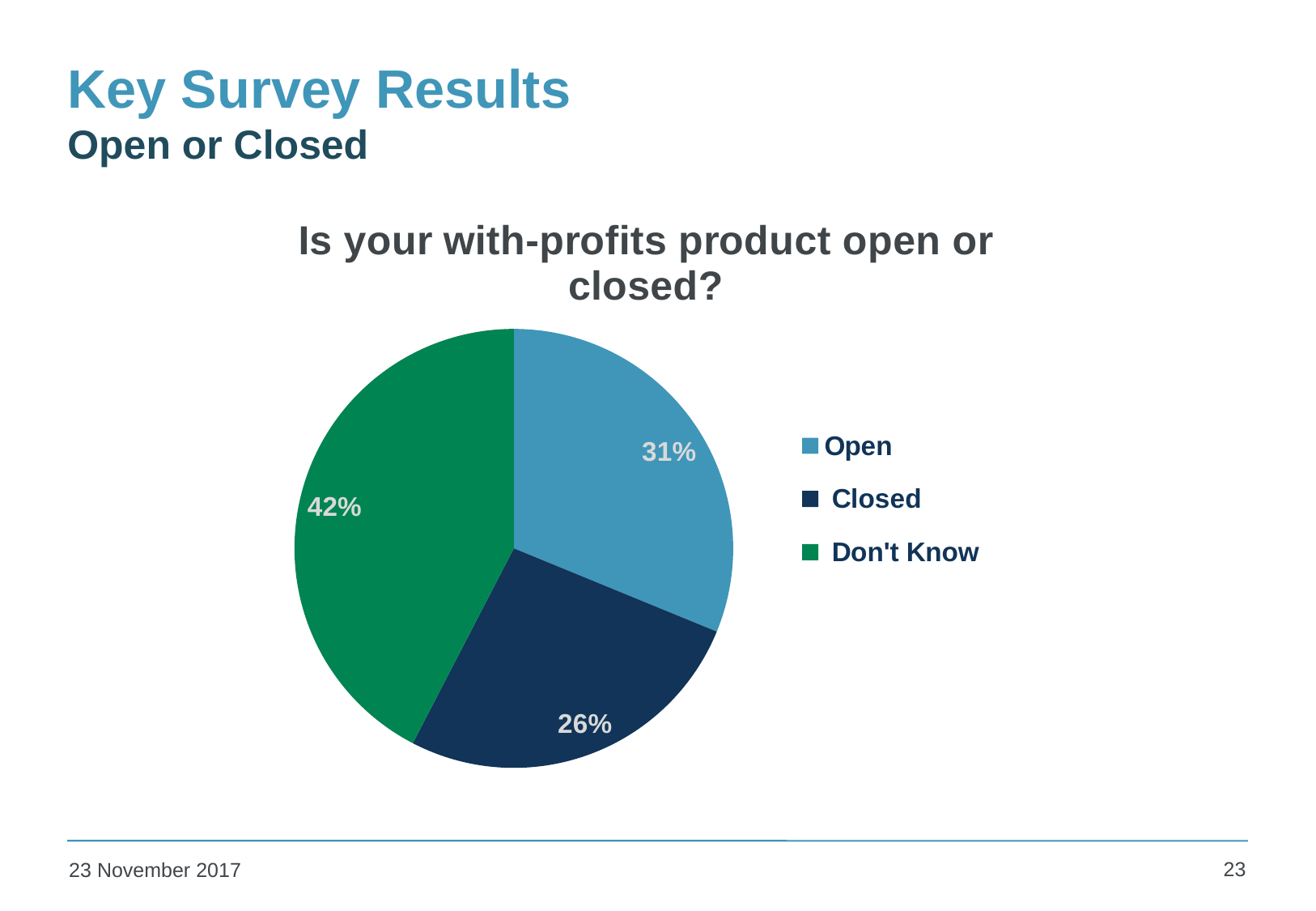
What percentage of respondents answered 'Don't Know'? 42% Which is larger, the share for 'Open' or the share for 'Closed'? Open Which response has the smallest share of the pie? Closed What is the difference in percentage points between 'Open' and 'Closed'? 5 What is the title of the chart? Is your with-profits product open or closed? What percentage of respondents said their with-profits product is closed? 26% How many categories are shown in the pie chart? 3 What percentage of respondents said their with-profits product is open? 31% What is the difference in percentage points between 'Don't Know' and 'Open'? 11 What type of chart is shown on the slide? Pie chart Which colour represents 'Don't Know' in the chart? Green Which response has the largest share of the pie? Don't Know